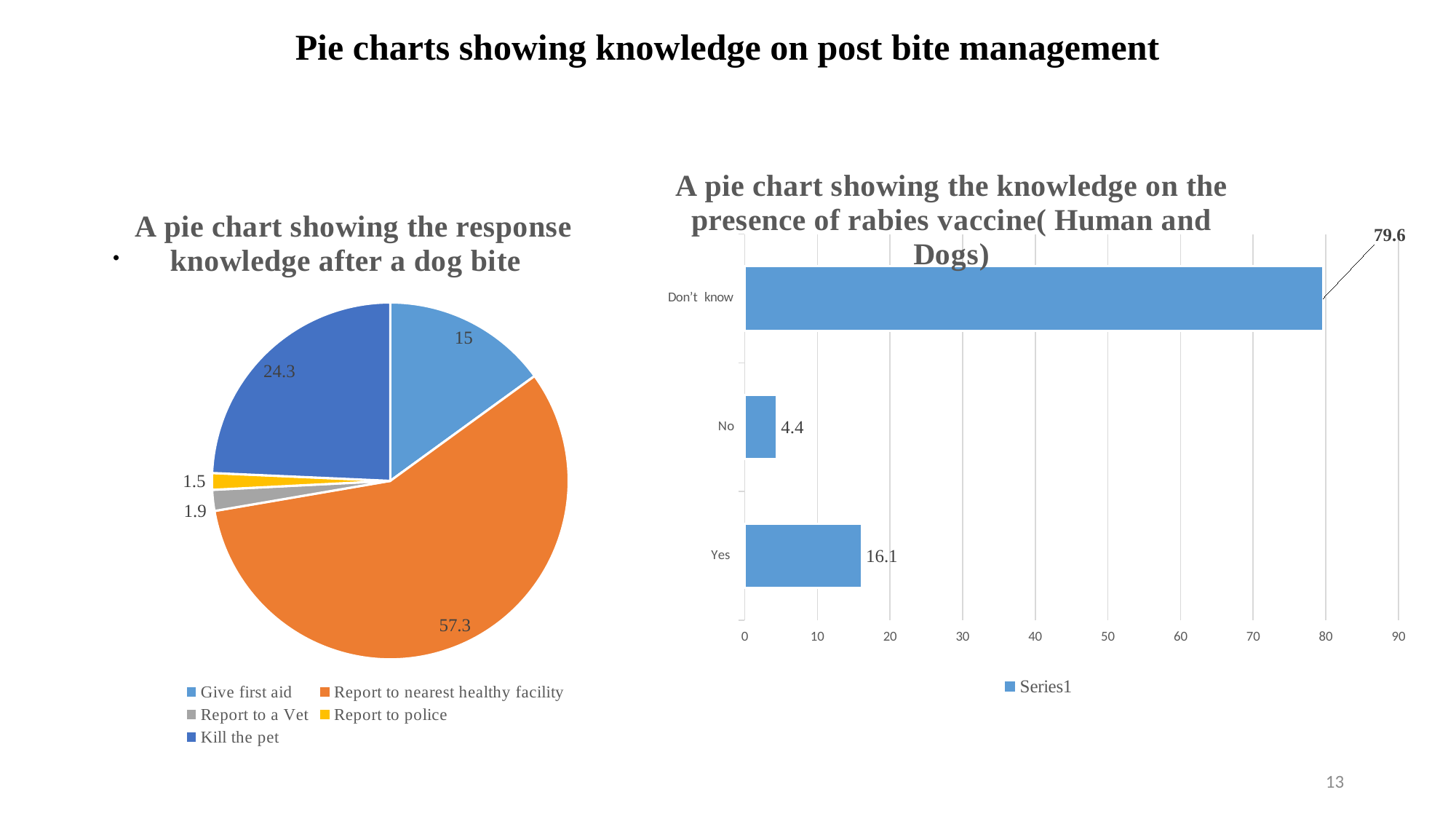
In the right chart (knowledge on the presence of rabies vaccine), which is larger, the value for 'Yes' or the value for 'No'? Yes In the left chart (response knowledge after a dog bite), what value is shown for 'Give first aid'? 15 In the left chart (response knowledge after a dog bite), what is the difference between the values for 'Kill the pet' and 'Give first aid'? 9.3 In the right chart (knowledge on the presence of rabies vaccine), what is the difference between the values for 'Don't know' and 'Yes'? 63.5 In the left chart (response knowledge after a dog bite), which category has the largest slice? Report to nearest healthy facility In the left chart (response knowledge after a dog bite), what value is shown for 'Kill the pet'? 24.3 What type of chart is the right chart (knowledge on the presence of rabies vaccine)? Bar chart In the left chart (response knowledge after a dog bite), which category has the smallest slice? Report to police In the right chart (knowledge on the presence of rabies vaccine), what is the value for 'Don't know'? 79.6 In the left chart (response knowledge after a dog bite), how many categories does the legend list? 5 In the left chart (response knowledge after a dog bite), what value is shown for 'Report to nearest healthy facility'? 57.3 In the right chart (knowledge on the presence of rabies vaccine), what is the value for 'No'? 4.4